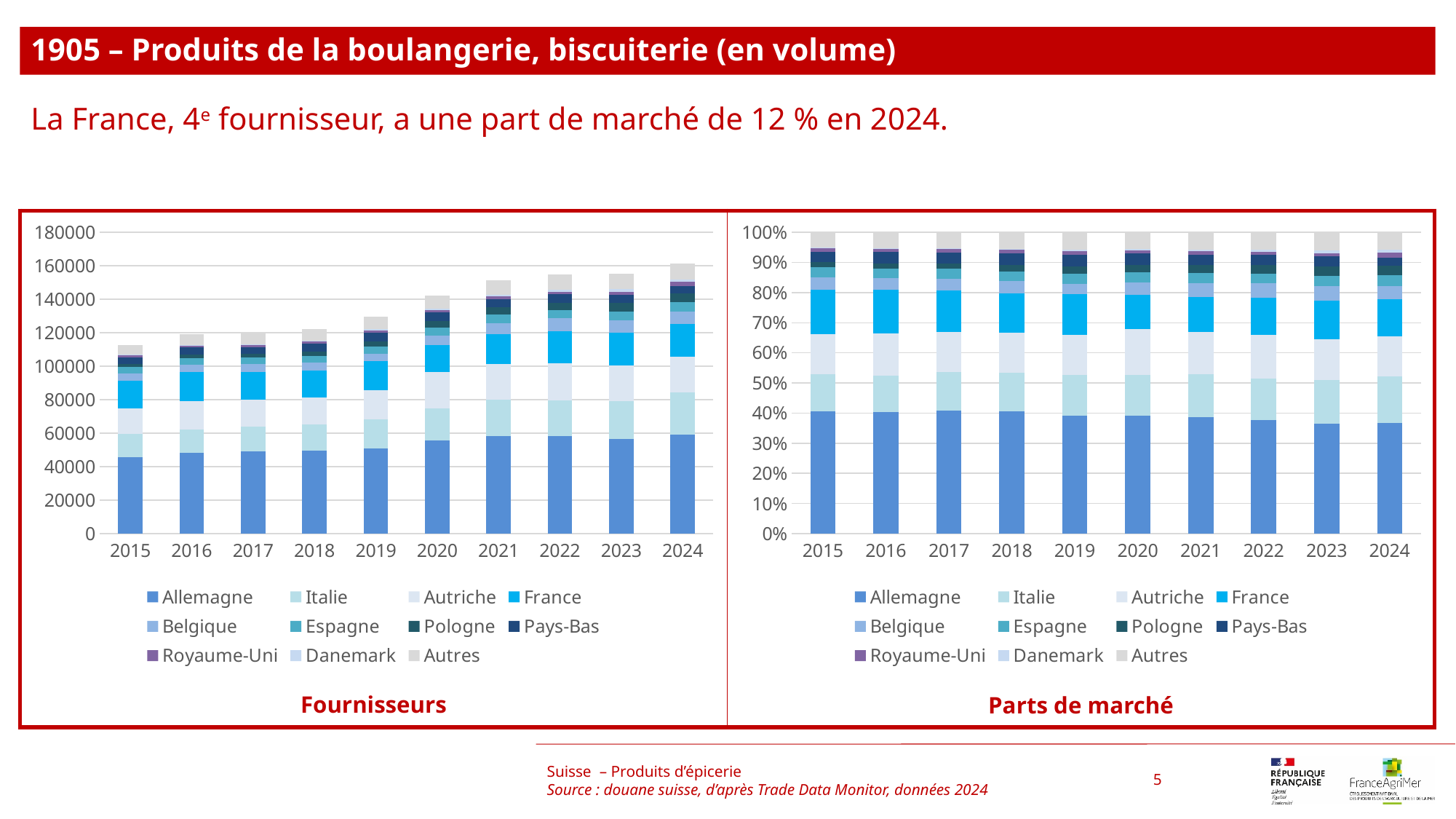
In the 'Fournisseurs' chart, do the total bars generally rise or fall from 2015 to 2024? Rise What kind of chart is the 'Parts de marché' chart? 100% stacked bar chart In the 'Fournisseurs' chart, is the Allemagne value for 2020 greater or less than 60000? less In the 'Parts de marché' chart, is the Allemagne share larger in 2015 or in 2024? 2015 In the 'Fournisseurs' chart, which year has the highest total bar? 2024 What kind of chart is the 'Fournisseurs' chart? Stacked bar chart In the 'Fournisseurs' chart, how many years are shown on the x axis? 10 In the 'Parts de marché' chart, is the Allemagne share for 2024 greater or less than 40%? less In the 'Fournisseurs' chart, which year has the lowest total bar? 2015 In the 'Fournisseurs' chart, which series is listed first in the legend? Allemagne In the 'Fournisseurs' chart, is the total for 2015 greater or less than 120000? less In the 'Parts de marché' chart, how many series does the legend list? 11